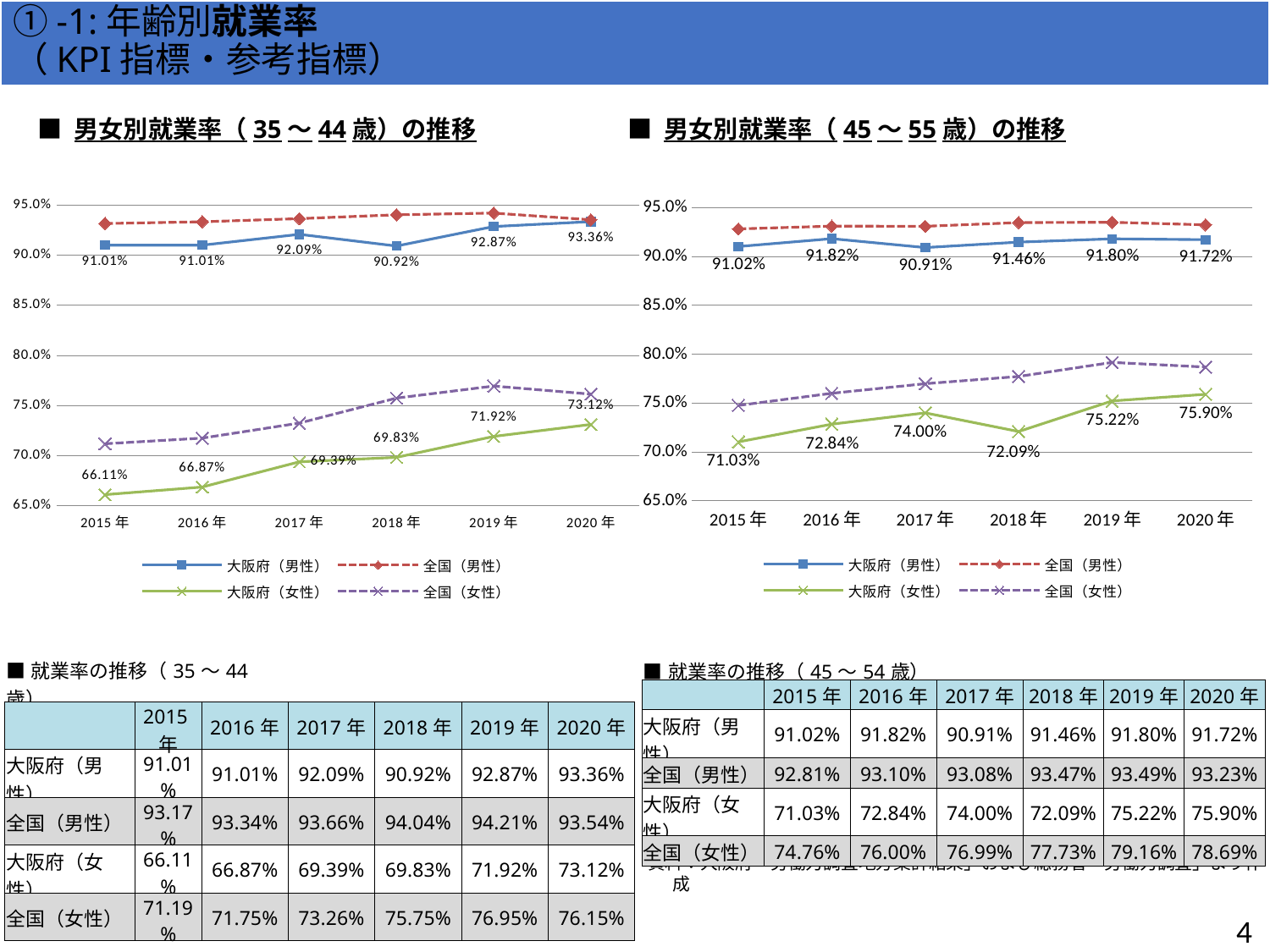
In the right chart (男女別就業率（45～55歳）の推移), what is the value for 大阪府（女性） in 2015年? 71.03% In the right chart (男女別就業率（45～55歳）の推移), what is the difference between the 大阪府（男性） values for 2016年 and 2015年? 0.80 percentage points How many series does the legend of the left chart (男女別就業率（35～44歳）の推移) list? 4 How many years are shown on the x axis of the right chart (男女別就業率（45～55歳）の推移)? 6 In the right chart (男女別就業率（45～55歳）の推移), in which year is the 大阪府（男性） value lowest? 2017年 In the left chart (男女別就業率（35～44歳）の推移), does the 大阪府（女性） series rise or fall from 2015年 to 2020年? Rises In the right chart (男女別就業率（45～55歳）の推移), which is larger for 大阪府（女性）: the 2017年 value or the 2018年 value? 2017年 In the right chart (男女別就業率（45～55歳）の推移), in which year is the 大阪府（女性） value highest? 2020年 What kind of chart is the left chart (男女別就業率（35～44歳）の推移)? Line chart In the left chart (男女別就業率（35～44歳）の推移), what is the value for 大阪府（男性） in 2020年? 93.36% In the left chart (男女別就業率（35～44歳）の推移), is the value for 全国（女性） in 2019年 greater or less than 75.0%? greater In the left chart (男女別就業率（35～44歳）の推移), what is the difference between the 大阪府（女性） values for 2020年 and 2015年? 7.01 percentage points